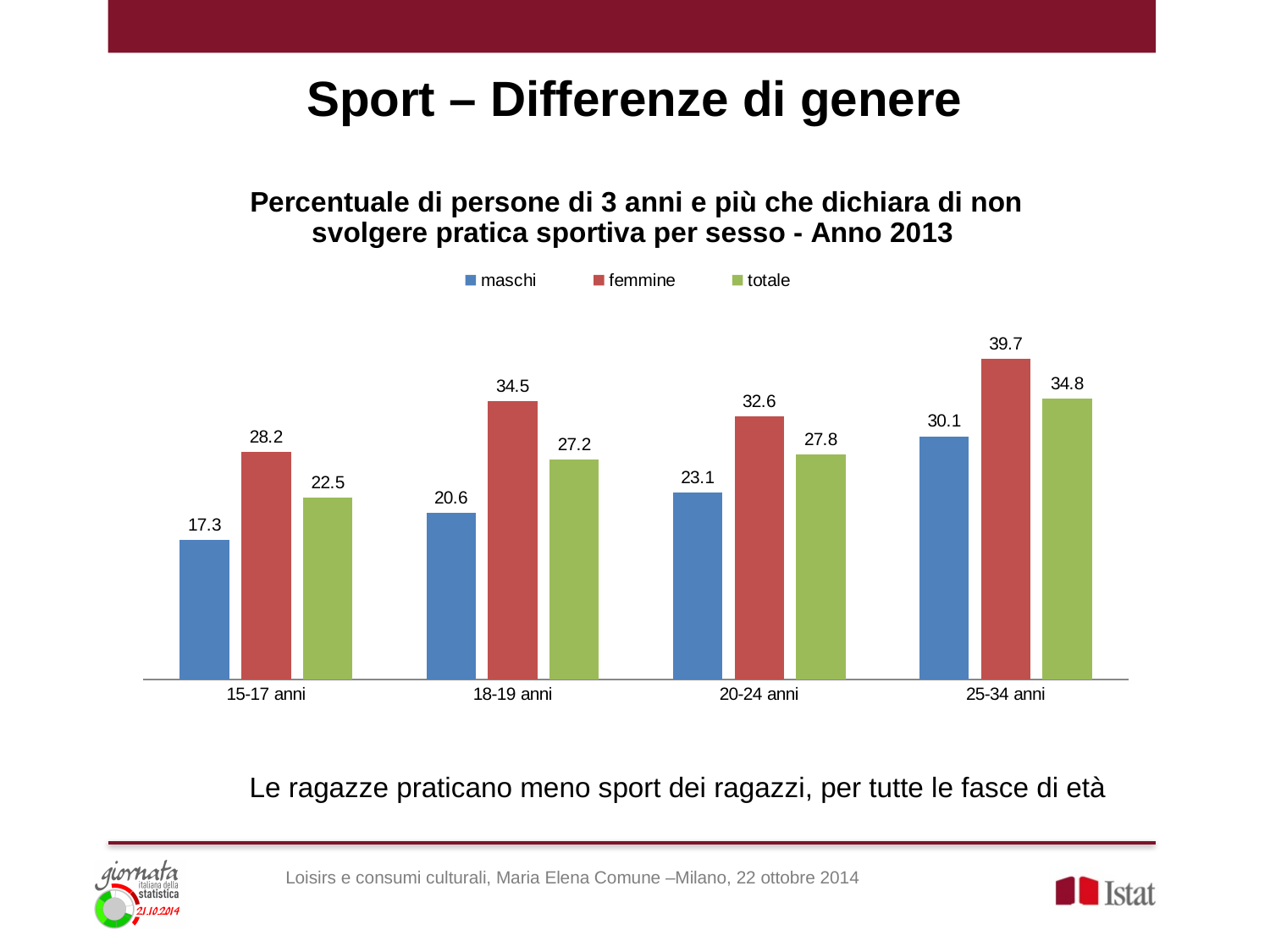
Which colour represents the femmine series in the chart? red What is the difference between the femmine and maschi values in the 20-24 anni age group? 9.5 Which age group has the highest value for femmine? 25-34 anni Which age group has the lowest value for maschi? 15-17 anni How many age groups are shown on the x axis? 4 What is the value for totale in the 15-17 anni age group? 22.5 What is the value for femmine in the 18-19 anni age group? 34.5 What kind of chart is shown on the slide? bar chart What is the value for maschi in the 25-34 anni age group? 30.1 Do the values for maschi rise or fall from 15-17 anni to 25-34 anni? rise Which is larger in the 25-34 anni age group, the value for femmine or the value for totale? femmine How many series does the legend list? 3